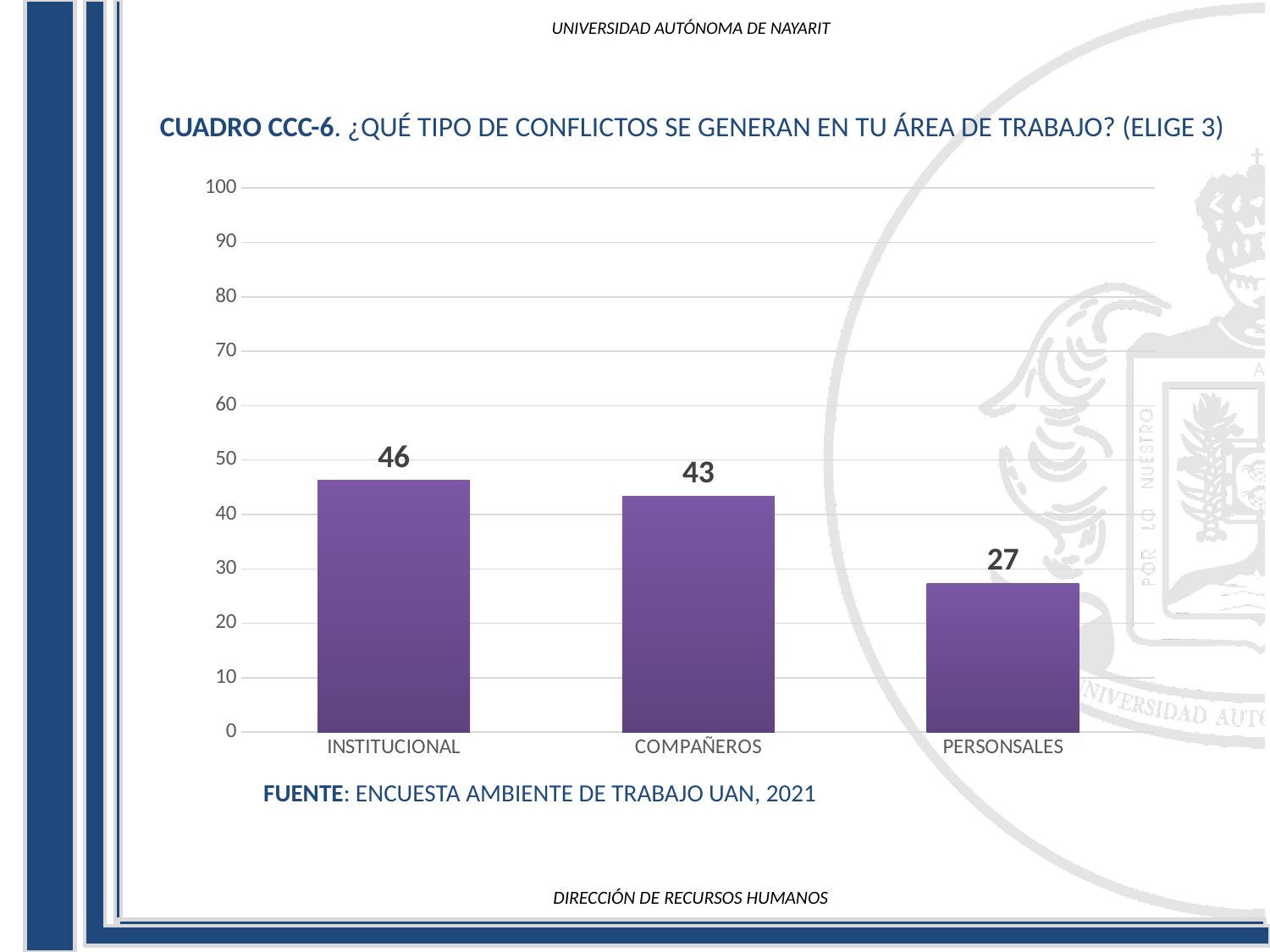
Which category has the lowest value? PERSONSALES Which is larger, the value for COMPAÑEROS or the value for PERSONSALES? COMPAÑEROS What is the value for COMPAÑEROS? 43 What is the value for INSTITUCIONAL? 46 What is the difference between the values for INSTITUCIONAL and PERSONSALES? 19 Is the value for PERSONSALES greater or less than 30? less Which category has the highest value? INSTITUCIONAL What is the source cited below the chart? ENCUESTA AMBIENTE DE TRABAJO UAN, 2021 What is the difference between the values for COMPAÑEROS and PERSONSALES? 16 What kind of chart is shown on the slide? bar chart What is the value for PERSONSALES? 27 How many categories are shown in the chart? 3